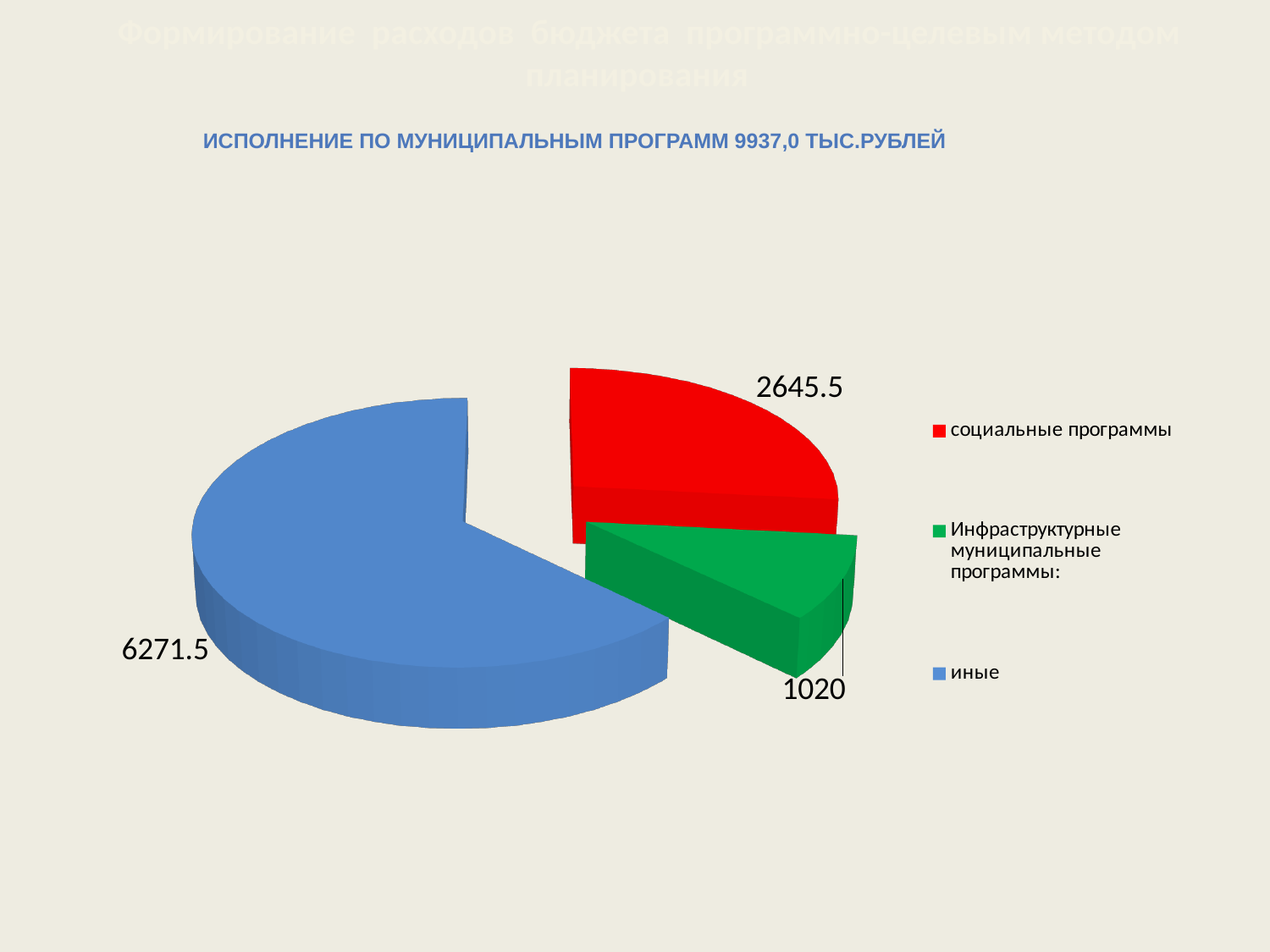
What is the difference between the values for иные and социальные программы? 3626 What is the value for иные? 6271.5 What colour is the slice for иные? blue Which is larger, the value for социальные программы or the value for Инфраструктурные муниципальные программы? социальные программы What is the total of all three slices in the pie chart? 9937 How many slices does the pie chart have? 3 What is the value for Инфраструктурные муниципальные программы? 1020 What is the difference between the values for социальные программы and Инфраструктурные муниципальные программы? 1625.5 What is the value for социальные программы? 2645.5 What type of chart is shown on the slide? pie chart Which category has the smallest slice of the pie? Инфраструктурные муниципальные программы Which category has the largest slice of the pie? иные